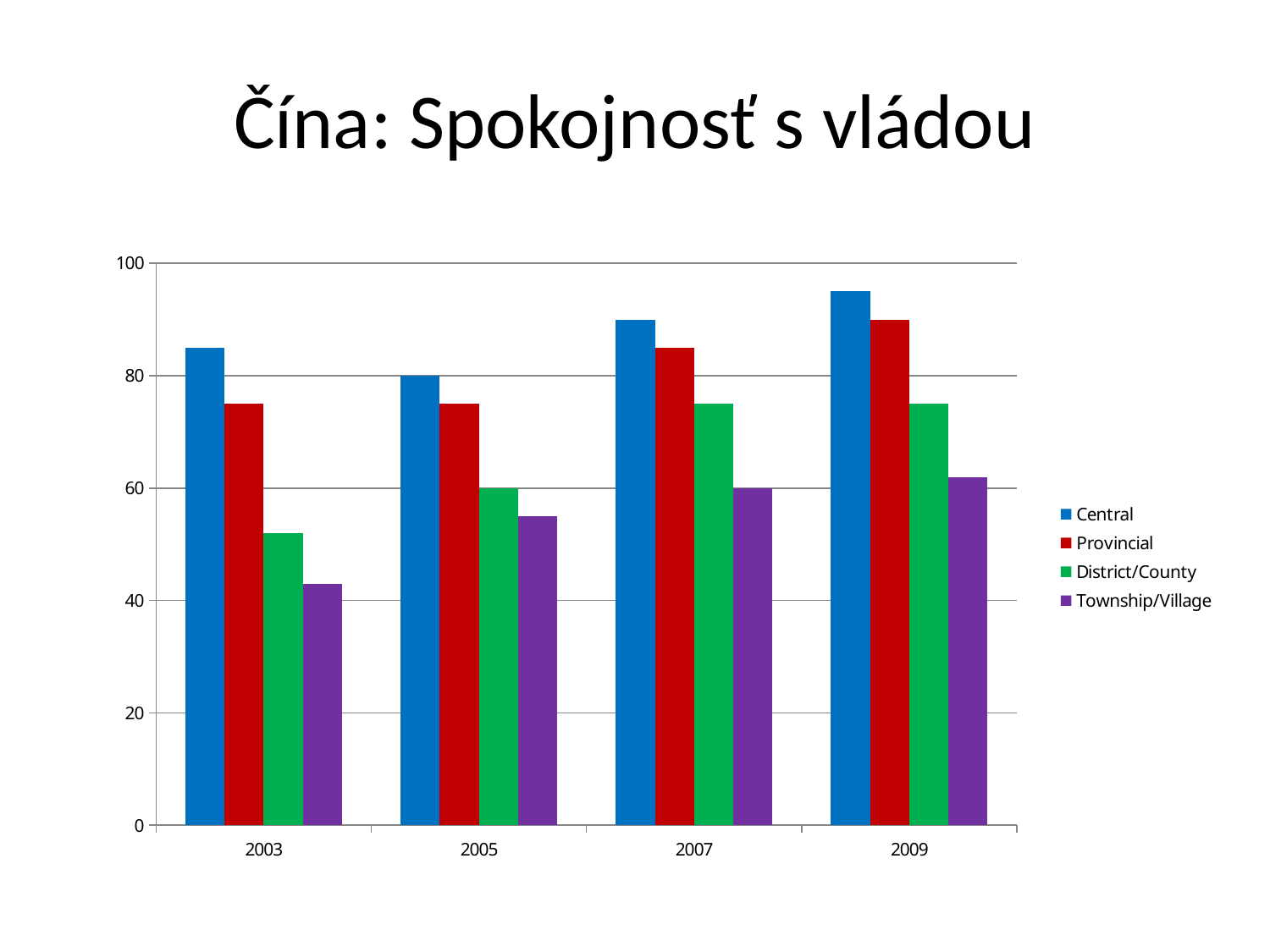
Is the value for District/County in 2003 greater or less than 60? less Which colour represents the Provincial series in the legend? red Is the value for Township/Village in 2003 greater or less than 60? less How many years are shown along the x axis? 4 In which year is the Central bar the highest? 2009 What is the title of the slide? Čína: Spokojnosť s vládou How many series does the legend list? 4 In 2007, which is larger: Central or Provincial? Central Do the Township/Village values rise or fall from 2003 to 2009? rise Which series has the lowest value in 2003? Township/Village Is the value for Central in 2009 greater or less than 80? greater What kind of chart is shown on the slide? bar chart